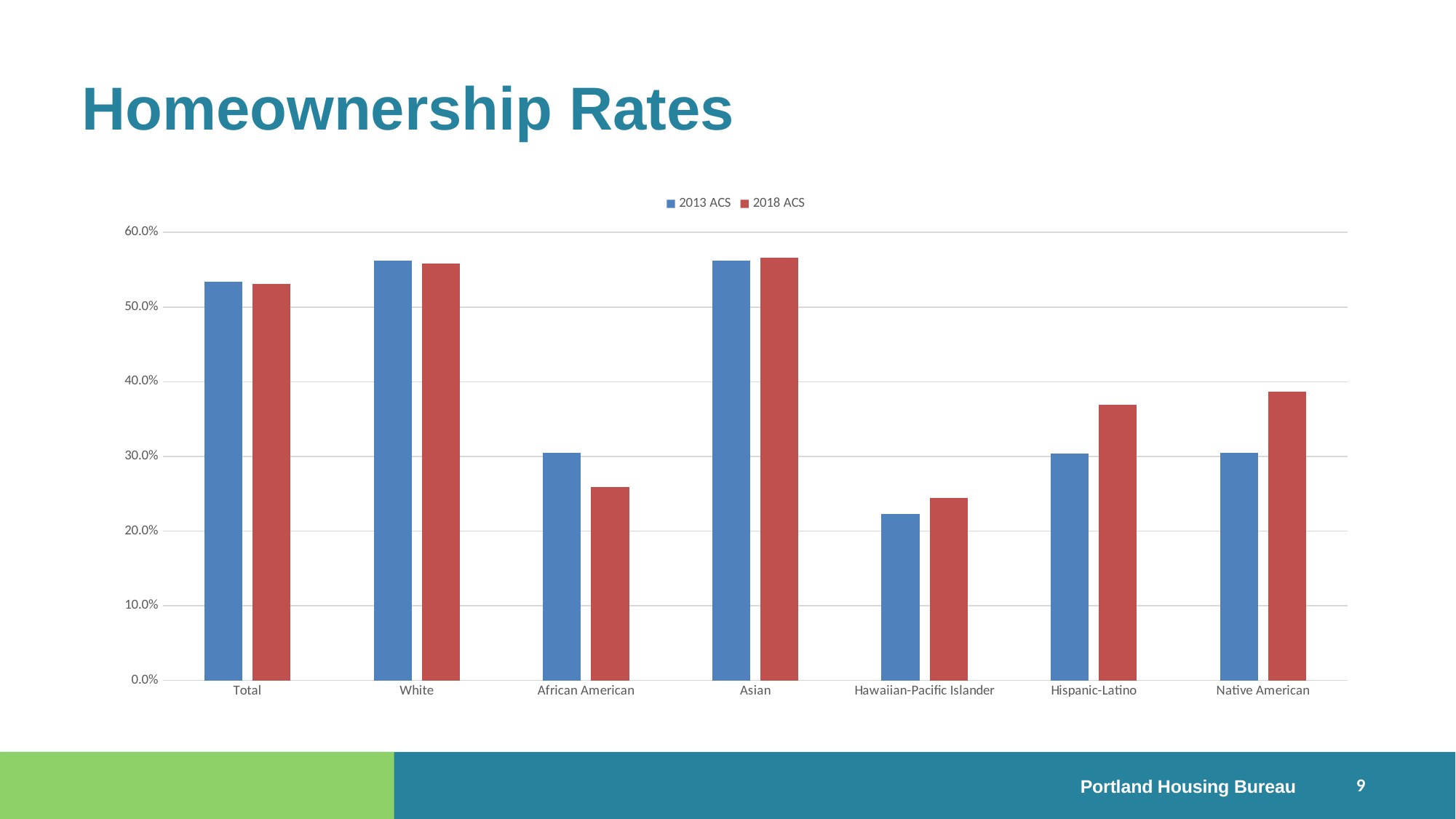
What kind of chart is shown on the slide? bar chart For African American, which is larger: the 2013 ACS value or the 2018 ACS value? 2013 ACS Is the 2018 ACS value for Native American greater or less than 40.0%? less How many series does the legend list? 2 Which category has the lowest 2013 ACS homeownership rate? Hawaiian-Pacific Islander What is the title of the slide containing the chart? Homeownership Rates Is the 2018 ACS value for African American greater or less than 30.0%? less How many categories are shown on the x axis? 7 Is the 2013 ACS value for Total greater or less than 50.0%? greater For Hispanic-Latino, which is larger: the 2013 ACS value or the 2018 ACS value? 2018 ACS Which category has the lowest 2018 ACS homeownership rate? Hawaiian-Pacific Islander